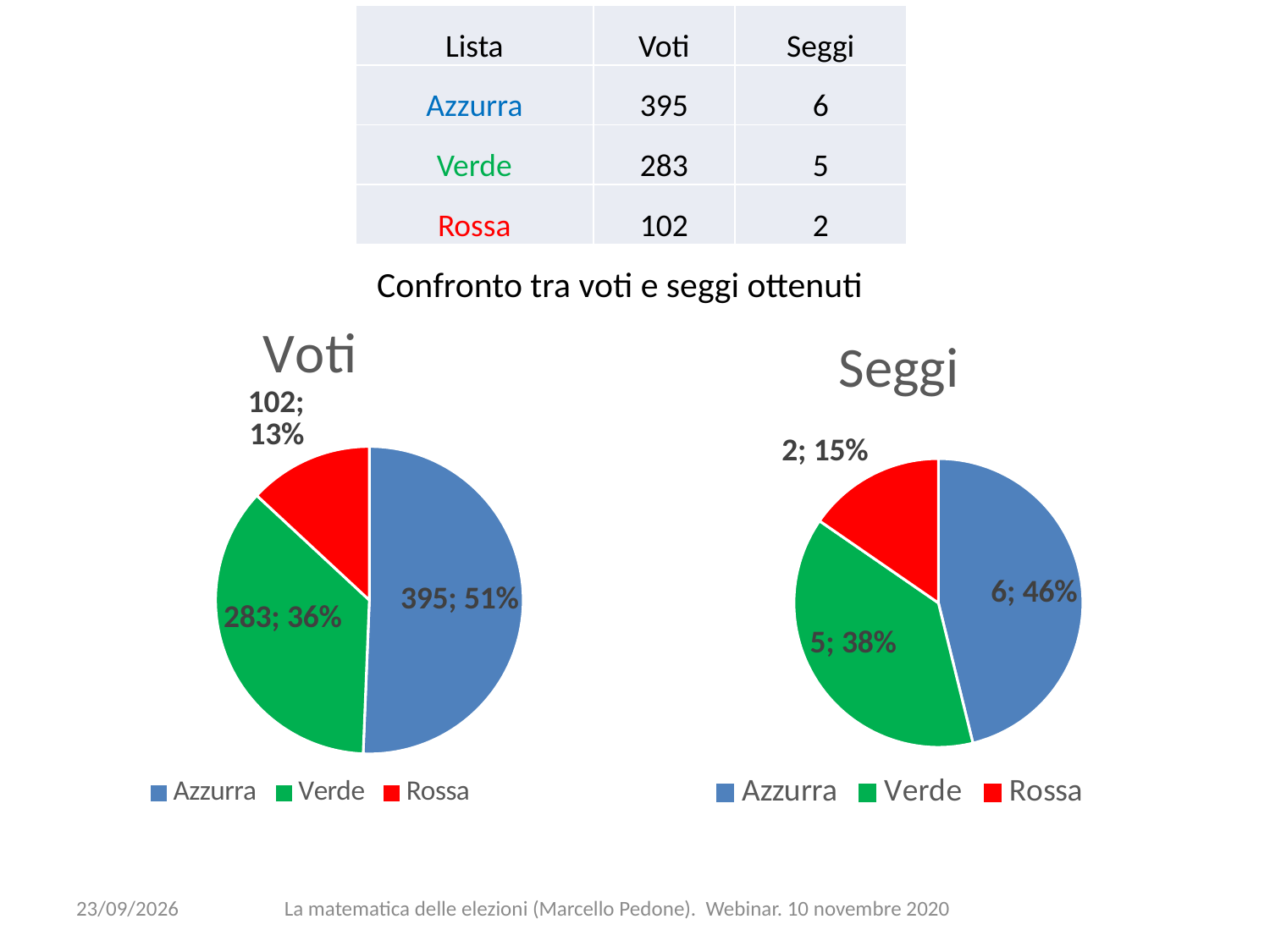
In the "Voti" pie chart, which is larger, the value for Verde or the value for Rossa? Verde What colour is the Verde slice in the "Seggi" pie chart? Green How many slices does the "Seggi" pie chart have? 3 In the "Seggi" pie chart, what value is shown for Rossa? 2 What kind of chart is the "Voti" chart? Pie chart In the "Voti" pie chart, what share of the pie does Verde have? 36% In the "Voti" pie chart, what is the difference between the values for Azzurra and Verde? 112 In the "Seggi" pie chart, what share of the pie does Azzurra have? 46% In the "Voti" pie chart, what value is shown for Azzurra? 395 In the "Seggi" pie chart, what is the difference between the values for Verde and Rossa? 3 In the "Seggi" pie chart, which list has the smallest slice? Rossa In the "Voti" pie chart, which list has the largest slice? Azzurra